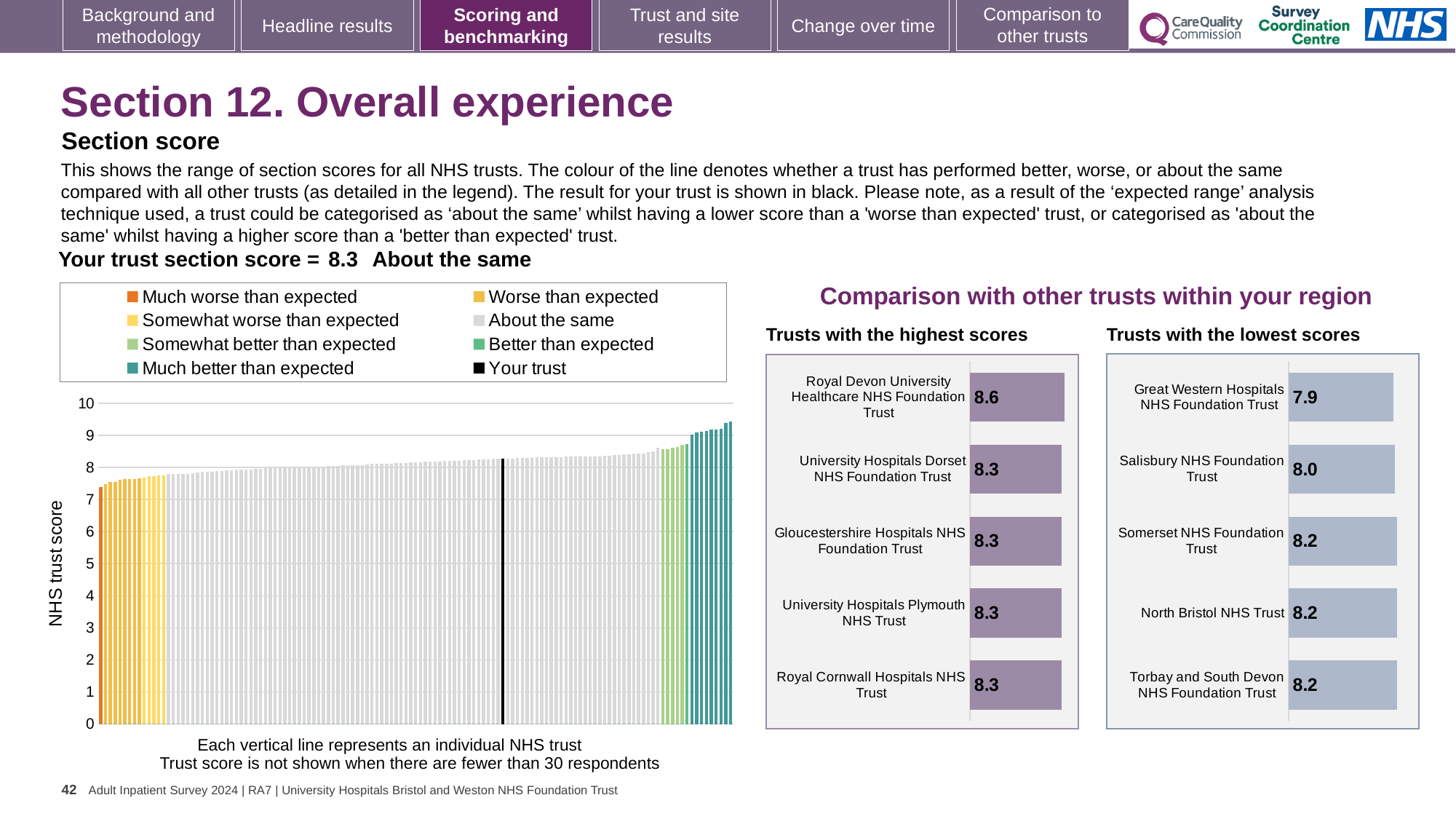
In the 'Trusts with the lowest scores' chart, what is the score for Salisbury NHS Foundation Trust? 8.0 In the 'Trusts with the highest scores' chart, which trust has the highest score? Royal Devon University Healthcare NHS Foundation Trust In the 'Trusts with the highest scores' chart, what is the difference between the score for Royal Devon University Healthcare NHS Foundation Trust and the score for University Hospitals Dorset NHS Foundation Trust? 0.3 What is the y-axis label of the large chart on the left? NHS trust score In the 'Trusts with the lowest scores' chart, which trust has the lowest score? Great Western Hospitals NHS Foundation Trust In the 'Trusts with the lowest scores' chart, what is the difference between the score for Salisbury NHS Foundation Trust and the score for Great Western Hospitals NHS Foundation Trust? 0.1 In the 'Trusts with the highest scores' chart, what is the score for Royal Devon University Healthcare NHS Foundation Trust? 8.6 What kind of chart is the large chart on the left showing NHS trust scores? Bar chart How many trusts are shown in the 'Trusts with the lowest scores' chart? 5 In the 'Trusts with the lowest scores' chart, which has the larger score: Somerset NHS Foundation Trust or Great Western Hospitals NHS Foundation Trust? Somerset NHS Foundation Trust In the large chart on the left, is the value for the black 'Your trust' bar greater or less than 8? greater How many entries does the legend of the large chart on the left list? 8